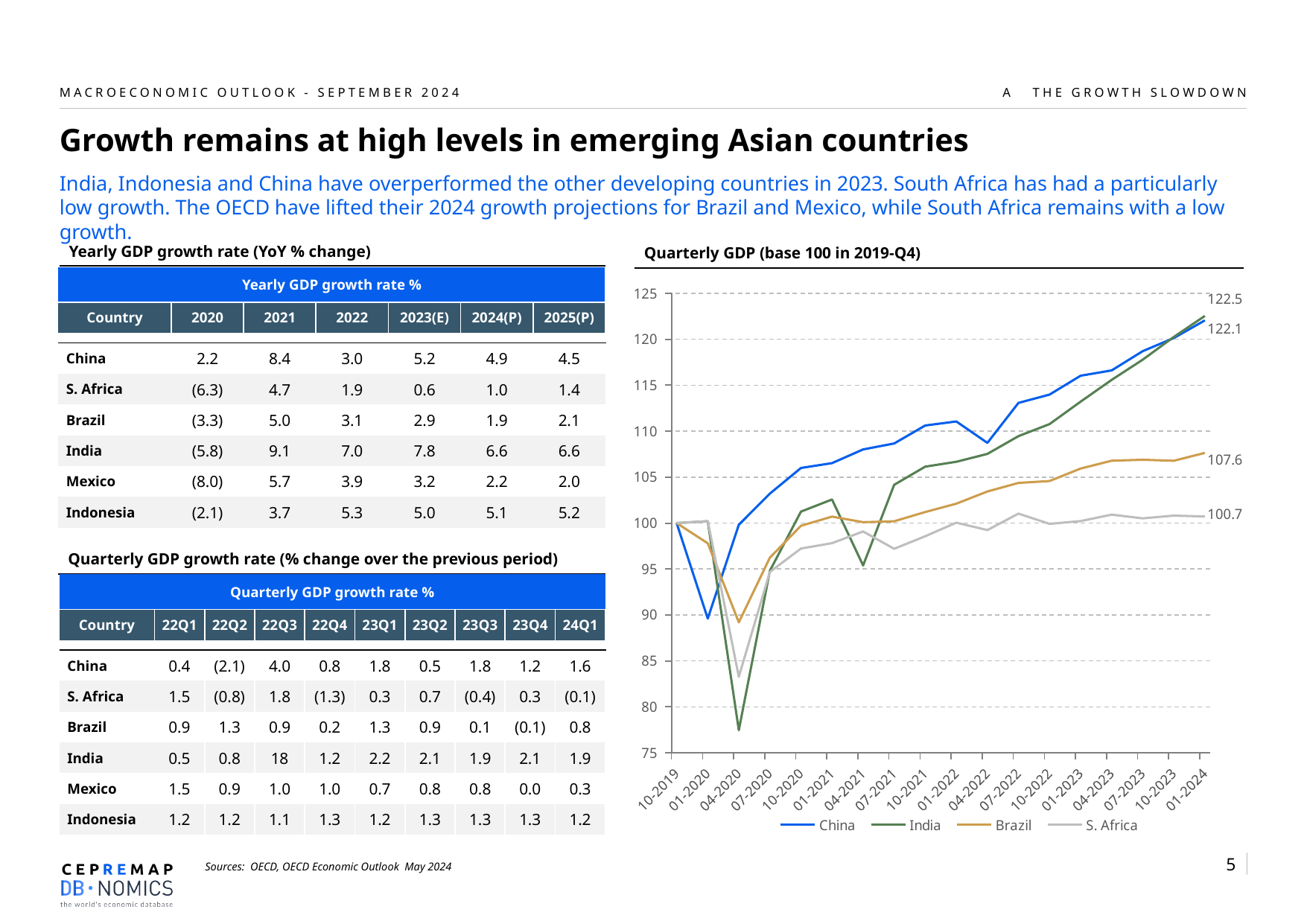
In the Quarterly GDP chart, what is the difference between the final labelled values of Brazil and S. Africa? 6.9 How many series does the legend of the Quarterly GDP chart list? 4 In the Quarterly GDP chart, what is the value labelled at the end of the Brazil line? 107.6 In the Quarterly GDP chart, does the S. Africa line rise or fall overall from 04-2020 to 01-2024? rise In the Quarterly GDP chart, is the value for India in 04-2021 greater or less than 100? less In the Quarterly GDP chart, what colour is the China line? blue In the Quarterly GDP chart, which series has the lowest value in 04-2020? India In the Quarterly GDP chart, is the value for India in 04-2020 greater or less than 80? less In the Quarterly GDP chart, is the value for China in 01-2020 greater or less than 95? less In the Quarterly GDP chart, which is larger at 01-2024: Brazil or S. Africa? Brazil In the Quarterly GDP chart, what is the value labelled at the end of the S. Africa line? 100.7 What kind of chart is the 'Quarterly GDP (base 100 in 2019-Q4)' chart? line chart